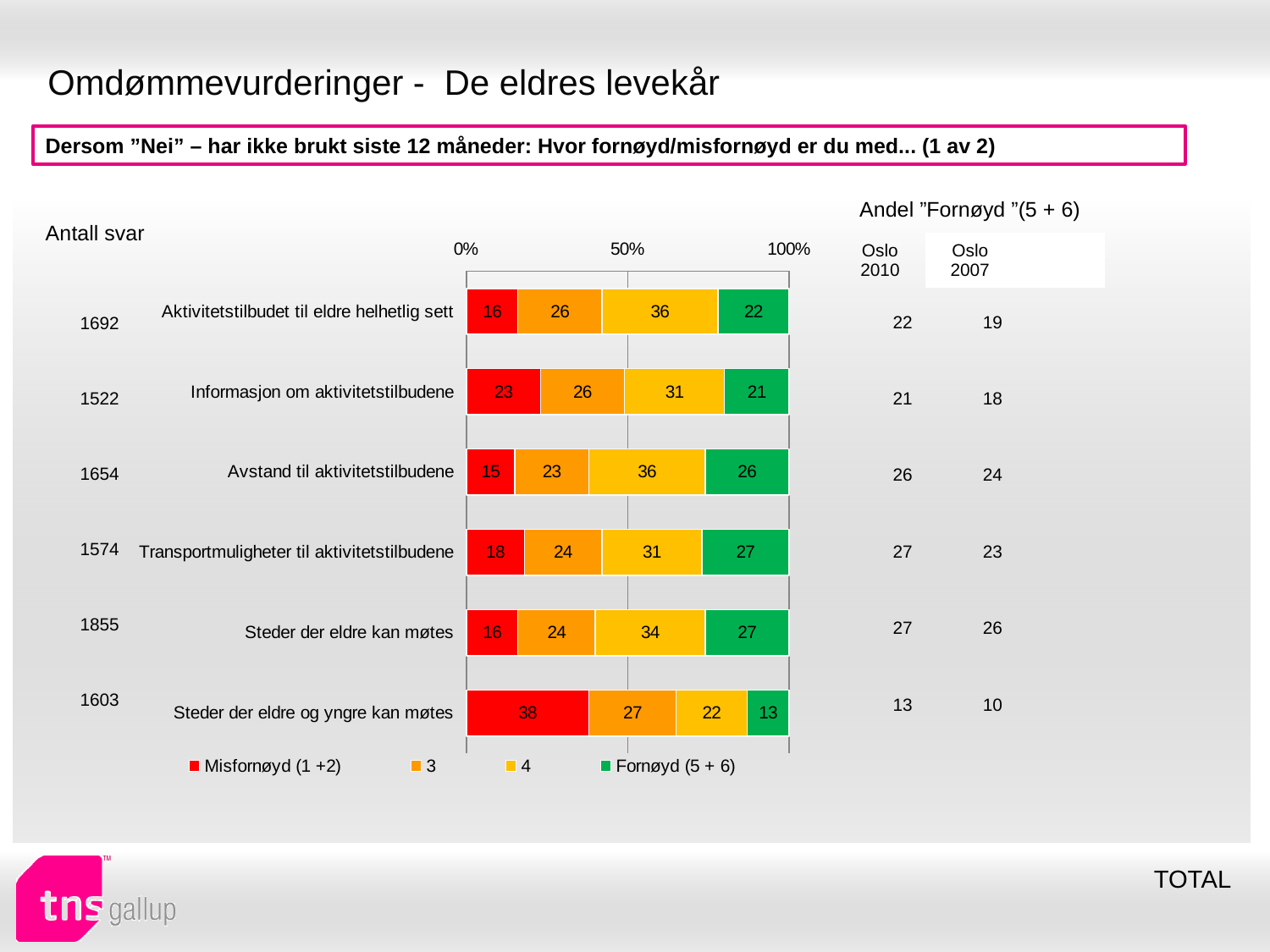
What is the value of the "4" segment for "Aktivitetstilbudet til eldre helhetlig sett"? 36 What kind of chart is shown on the slide? Stacked bar chart What is the value of the Misfornøyd (1 +2) segment for "Steder der eldre og yngre kan møtes"? 38 Which category has the lowest Fornøyd (5 + 6) value? Steder der eldre og yngre kan møtes How many categories are shown in the bar chart? 6 What colour represents the Fornøyd (5 + 6) series in the chart? Green What is the total of the stacked bar for "Steder der eldre kan møtes"? 101 How many series does the legend list? 4 Which is larger: the Fornøyd (5 + 6) value for "Transportmuligheter til aktivitetstilbudene" or for "Informasjon om aktivitetstilbudene"? Transportmuligheter til aktivitetstilbudene Which category has the highest Misfornøyd (1 +2) value? Steder der eldre og yngre kan møtes What is the value of the Fornøyd (5 + 6) segment for "Avstand til aktivitetstilbudene"? 26 What is the difference between the Misfornøyd (1 +2) values for "Informasjon om aktivitetstilbudene" and "Avstand til aktivitetstilbudene"? 8